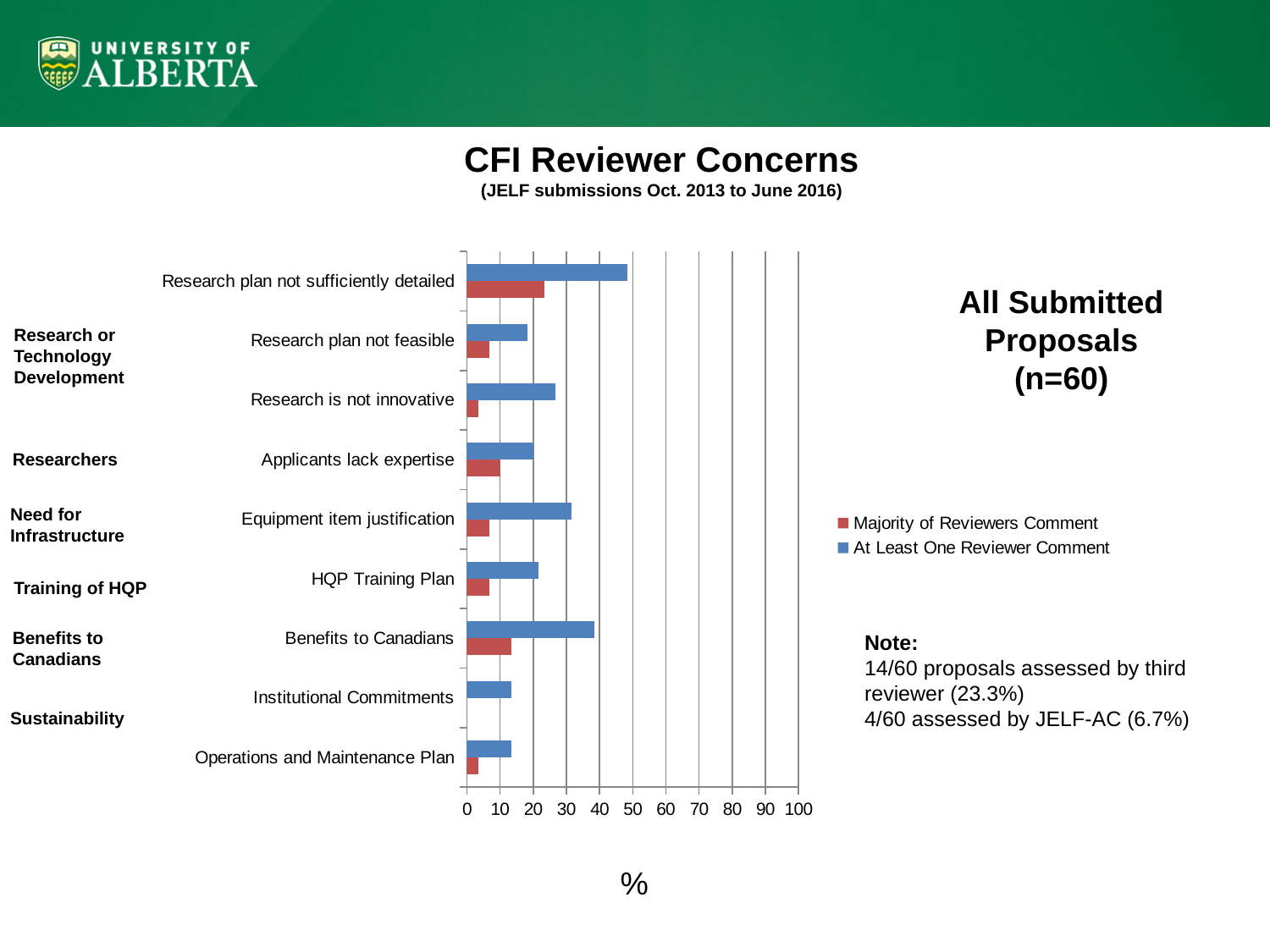
How many series does the chart legend list? 2 How many concern categories are plotted on the chart? 9 Is the At Least One Reviewer Comment value for Research plan not sufficiently detailed greater or less than 40? greater Which concern has the highest value for At Least One Reviewer Comment? Research plan not sufficiently detailed What is the title of the chart? CFI Reviewer Concerns For At Least One Reviewer Comment, which is larger: Benefits to Canadians or Equipment item justification? Benefits to Canadians Is the At Least One Reviewer Comment value for Research is not innovative greater or less than 20? greater Which concern has the highest value for Majority of Reviewers Comment? Research plan not sufficiently detailed Is the At Least One Reviewer Comment value for Research plan not feasible greater or less than 30? less For Majority of Reviewers Comment, which is larger: Applicants lack expertise or Research is not innovative? Applicants lack expertise What kind of chart is shown on the slide? bar chart